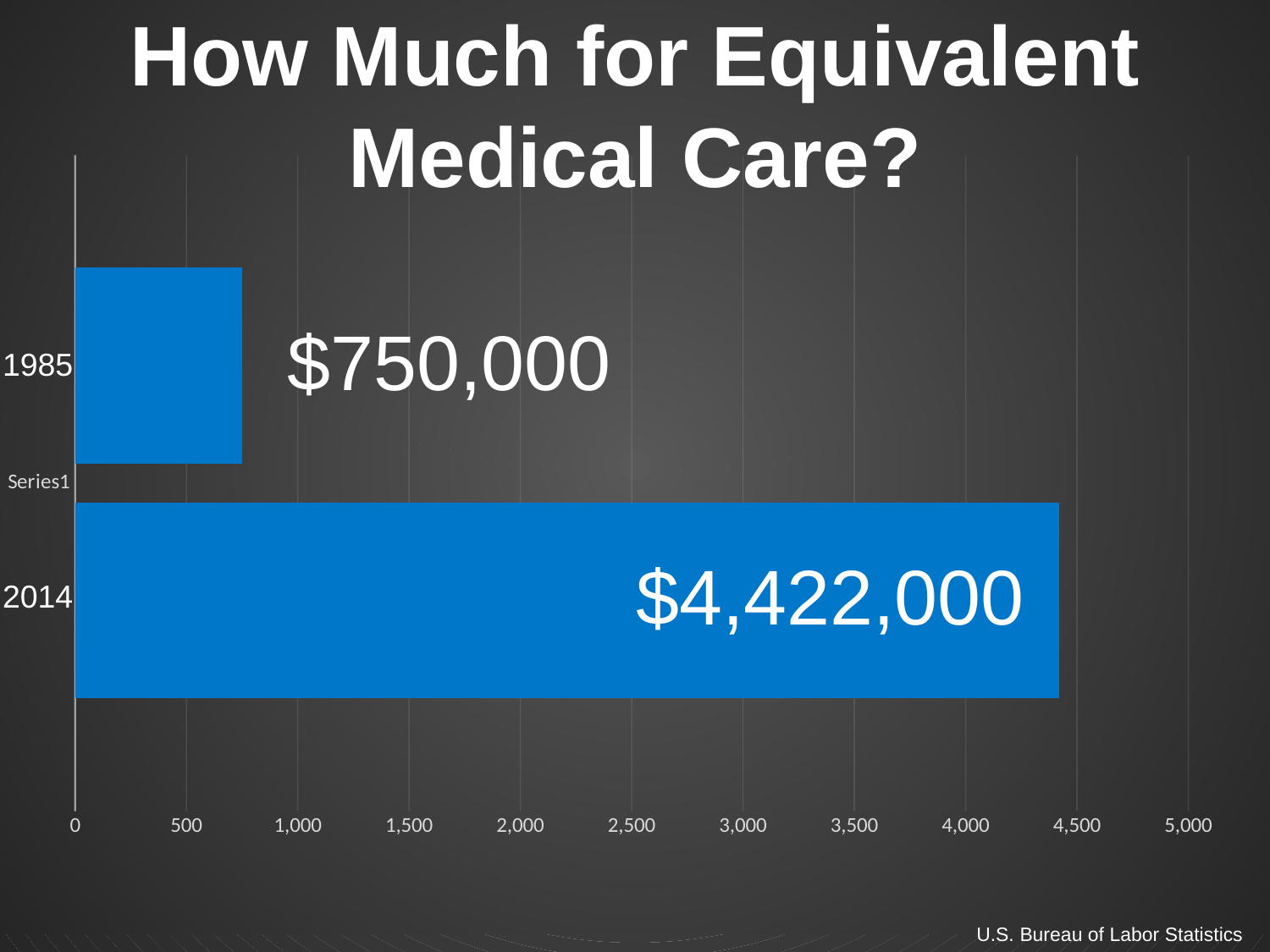
What is the title of the chart? How Much for Equivalent Medical Care? What is the difference between the 2014 value and the 1985 value? $3,672,000 Which year has the lower value? 1985 What kind of chart is shown on the slide? bar chart Which year has the higher value? 2014 How many bars are plotted in the chart? 2 Is the bar for 1985 greater or less than 1,000 on the axis? less What value is shown for 2014? $4,422,000 What value is shown for 1985? $750,000 What is the highest value shown on the horizontal axis? 5,000 Is the bar for 2014 greater or less than 4,000 on the axis? greater Is the value for 2014 larger or smaller than the value for 1985? larger